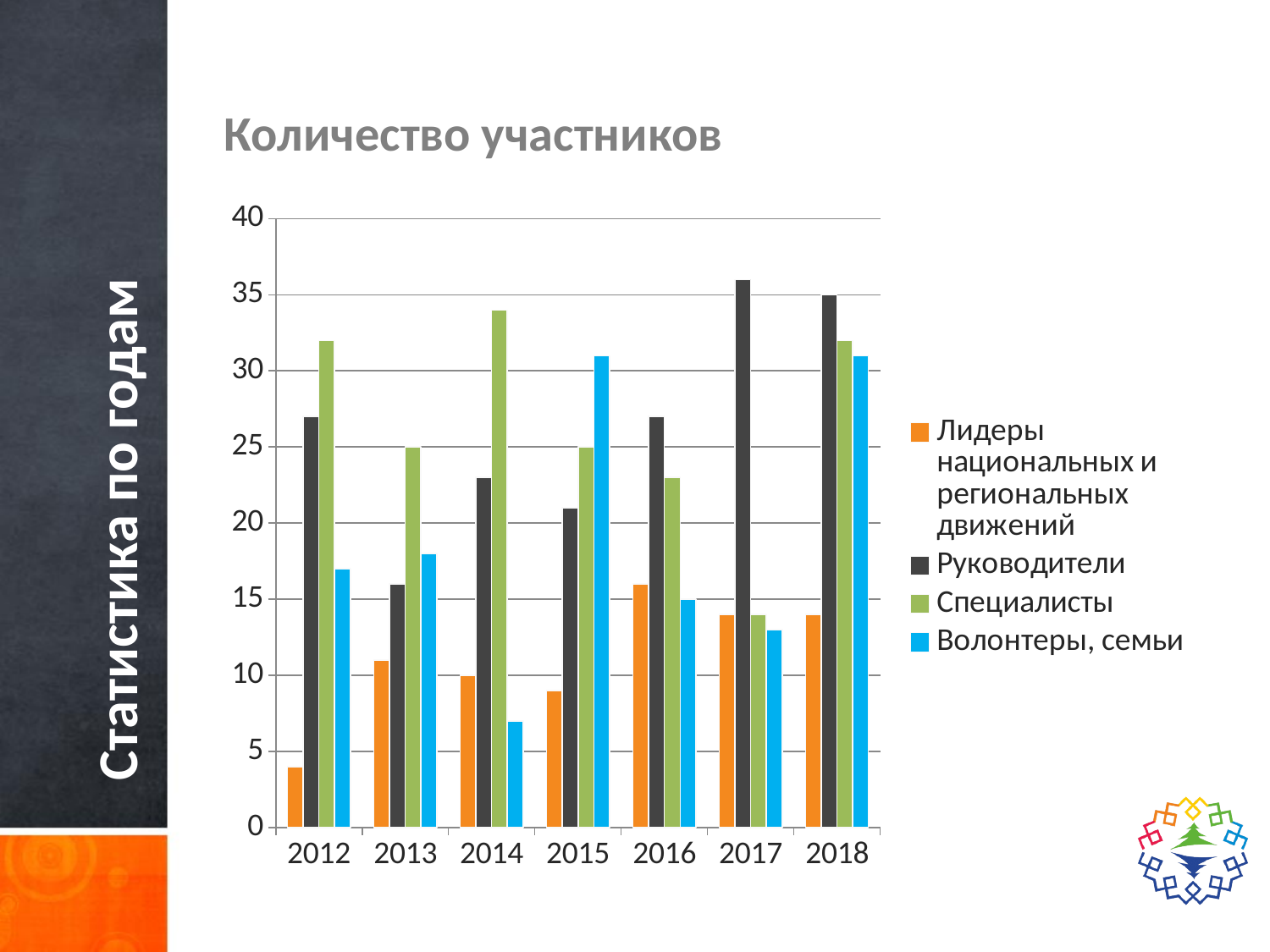
In 2012, which is larger: Руководители or Специалисты? Специалисты What is the value for Специалисты in 2013? 25 What is the value for Волонтеры, семьи in 2016? 15 What is the value for Руководители in 2018? 35 In which year is the value for Волонтеры, семьи the lowest? 2014 Is the value for Лидеры национальных и региональных движений in 2012 greater or less than 5? less How many series does the legend list? 4 What kind of chart is shown on the slide? bar chart What is the title of the chart? Количество участников Is the value for Руководители in 2017 greater or less than 35? greater How many years are shown on the x axis? 7 In which year is the value for Специалисты the highest? 2014